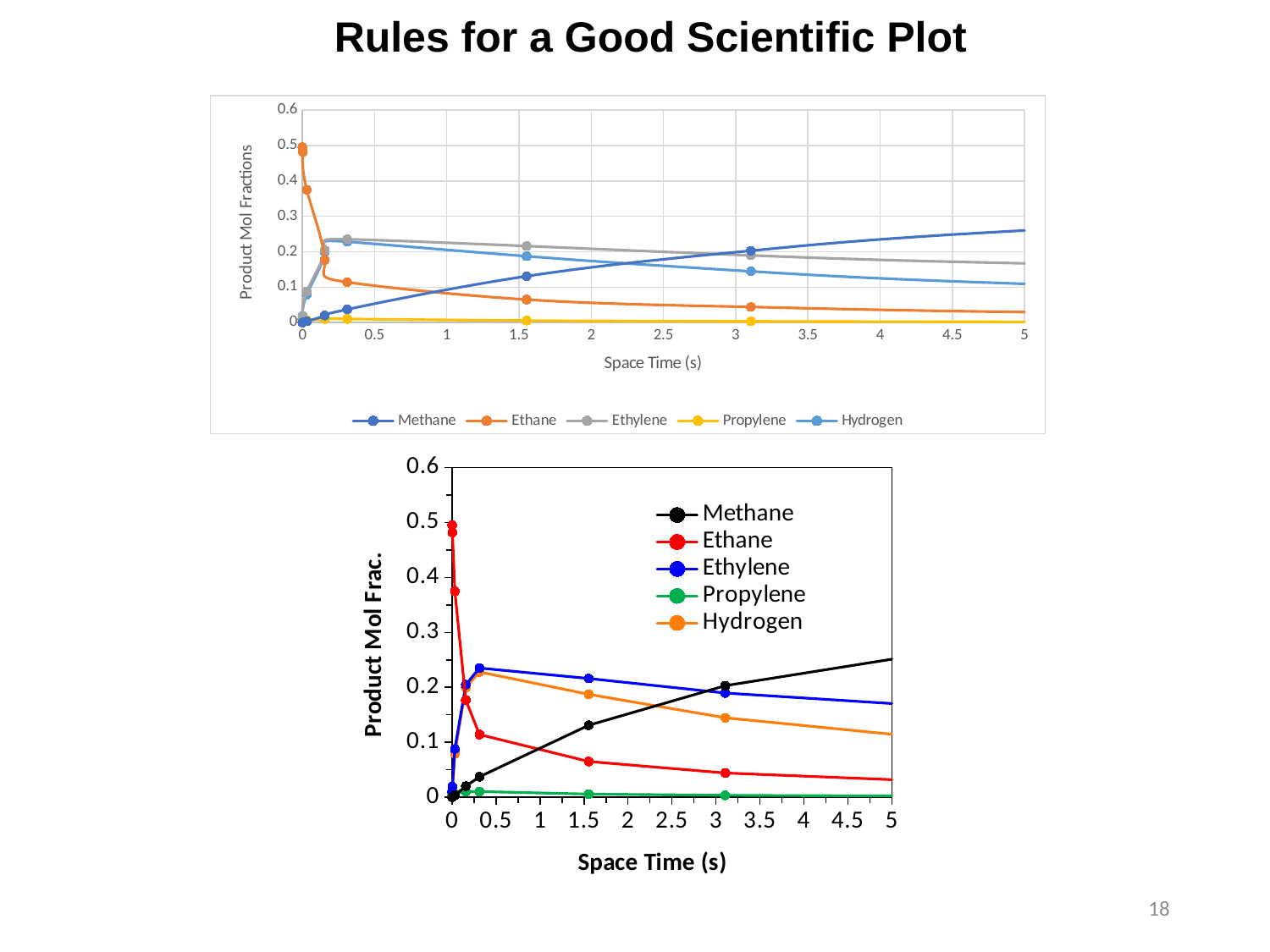
In the bottom chart, is the value for Hydrogen at a space time of 5 s greater or less than 0.2? less In the bottom chart, which series has the highest value at a space time of 0 s? Ethane In the bottom chart, does the Ethane series rise or fall as space time increases? fall What is the x-axis title of the bottom chart? Space Time (s) In the bottom chart, is the value for Propylene at a space time of 3 s greater or less than 0.1? less In the bottom chart, what colour is the Methane series? black How many series does the legend of the bottom chart list? 5 In the bottom chart, is the value for Methane at a space time of 5 s greater or less than 0.2? greater In the bottom chart, does the Methane series rise or fall as space time increases? rise What kind of chart is the top chart on the slide? line chart In the bottom chart, at a space time of 5 s, which is larger: Methane or Ethylene? Methane